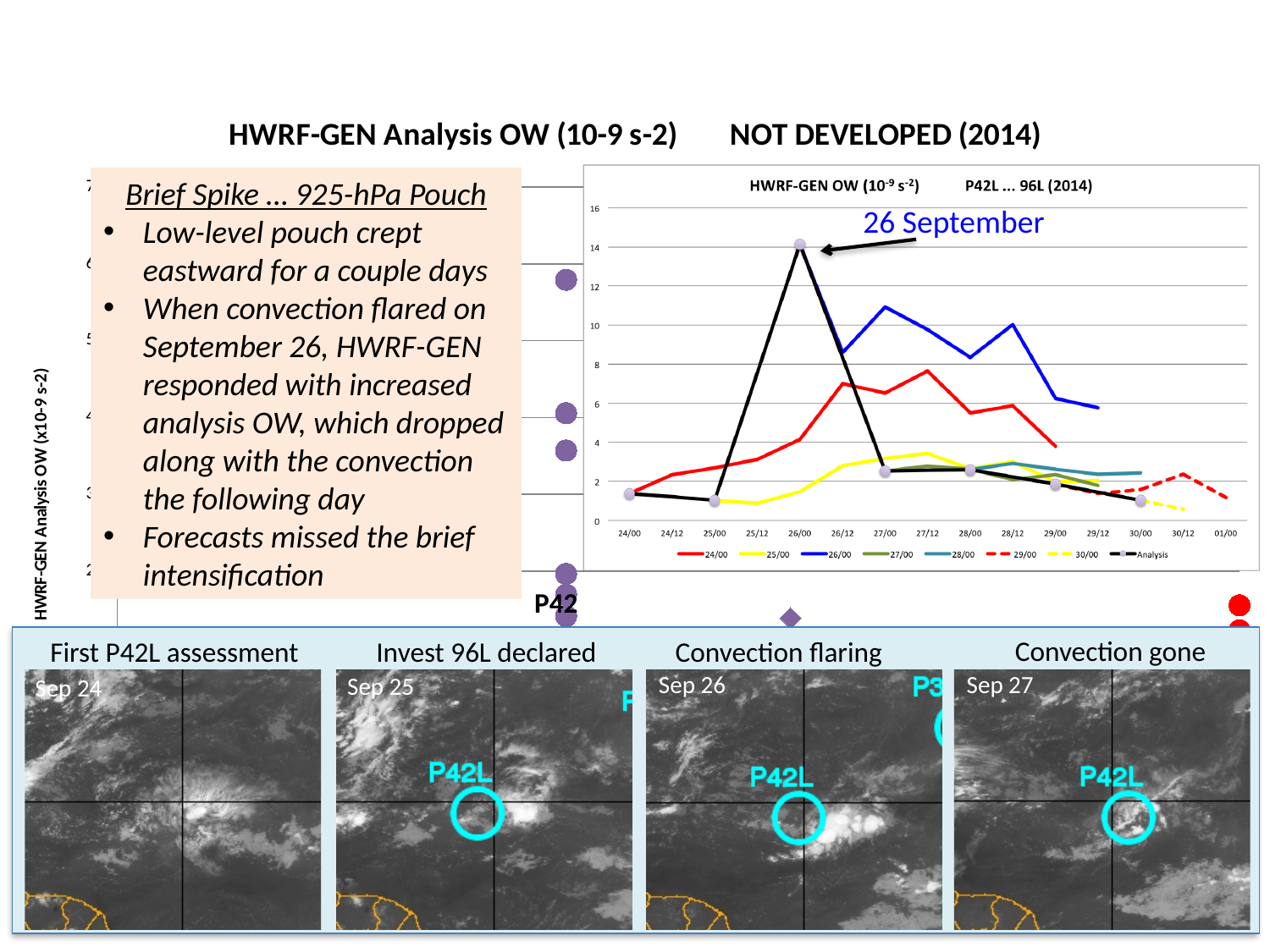
What colour is the Analysis series line in the HWRF-GEN OW chart? black In the HWRF-GEN OW chart, at 27/00, which series has the larger value: 26/00 or 24/00? 26/00 In the HWRF-GEN OW chart, does the Analysis series rise or fall from 26/00 to 30/00? fall How many series does the legend of the HWRF-GEN OW chart list? 8 How many tick labels are shown along the x axis of the HWRF-GEN OW chart? 15 In the HWRF-GEN OW chart, is the Analysis value at 26/00 greater or less than 12? greater What kind of chart is the inset chart titled "HWRF-GEN OW" on the slide? line chart In the HWRF-GEN OW chart, is the peak of the 26/00 series (at 27/00) greater or less than 10? greater In the HWRF-GEN OW chart, which series reaches the highest value on the chart? Analysis Which date is annotated with an arrow pointing to the peak in the HWRF-GEN OW chart? 26 September In the HWRF-GEN OW chart, is the Analysis value at 25/00 greater or less than 2? less